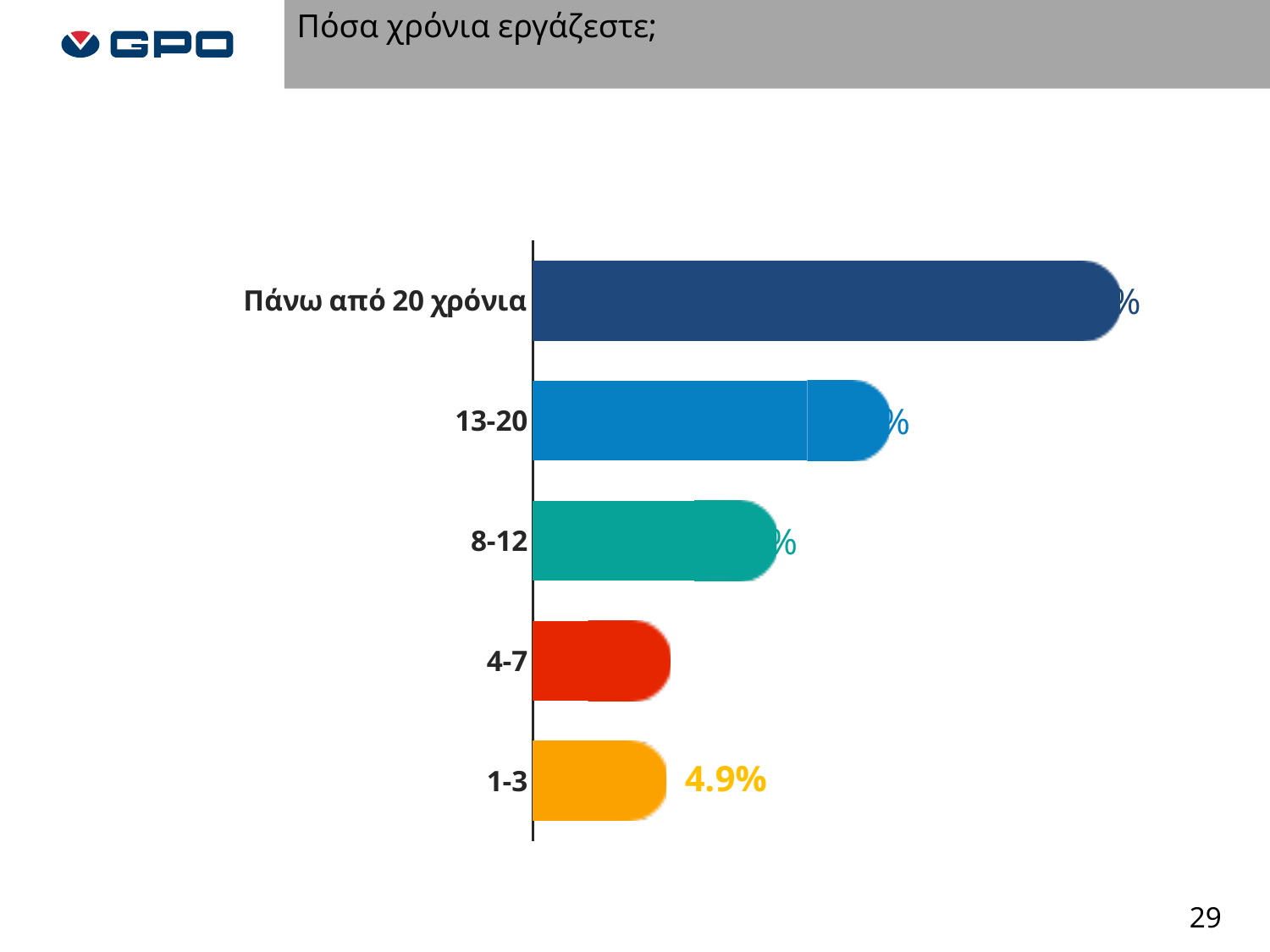
Which is larger, the value for 13-20 or the value for 8-12? 13-20 What is the title of the slide? Πόσα χρόνια εργάζεστε; Which is larger, the value for 8-12 or the value for 1-3? 8-12 What is the value shown for the 1-3 category? 4.9% Which category has the highest value? Πάνω από 20 χρόνια Which is larger, the value for Πάνω από 20 χρόνια or the value for 13-20? Πάνω από 20 χρόνια What colour is the bar for the 1-3 category? Yellow/orange How many categories are shown in the chart? 5 What kind of chart is shown on the slide? Bar chart